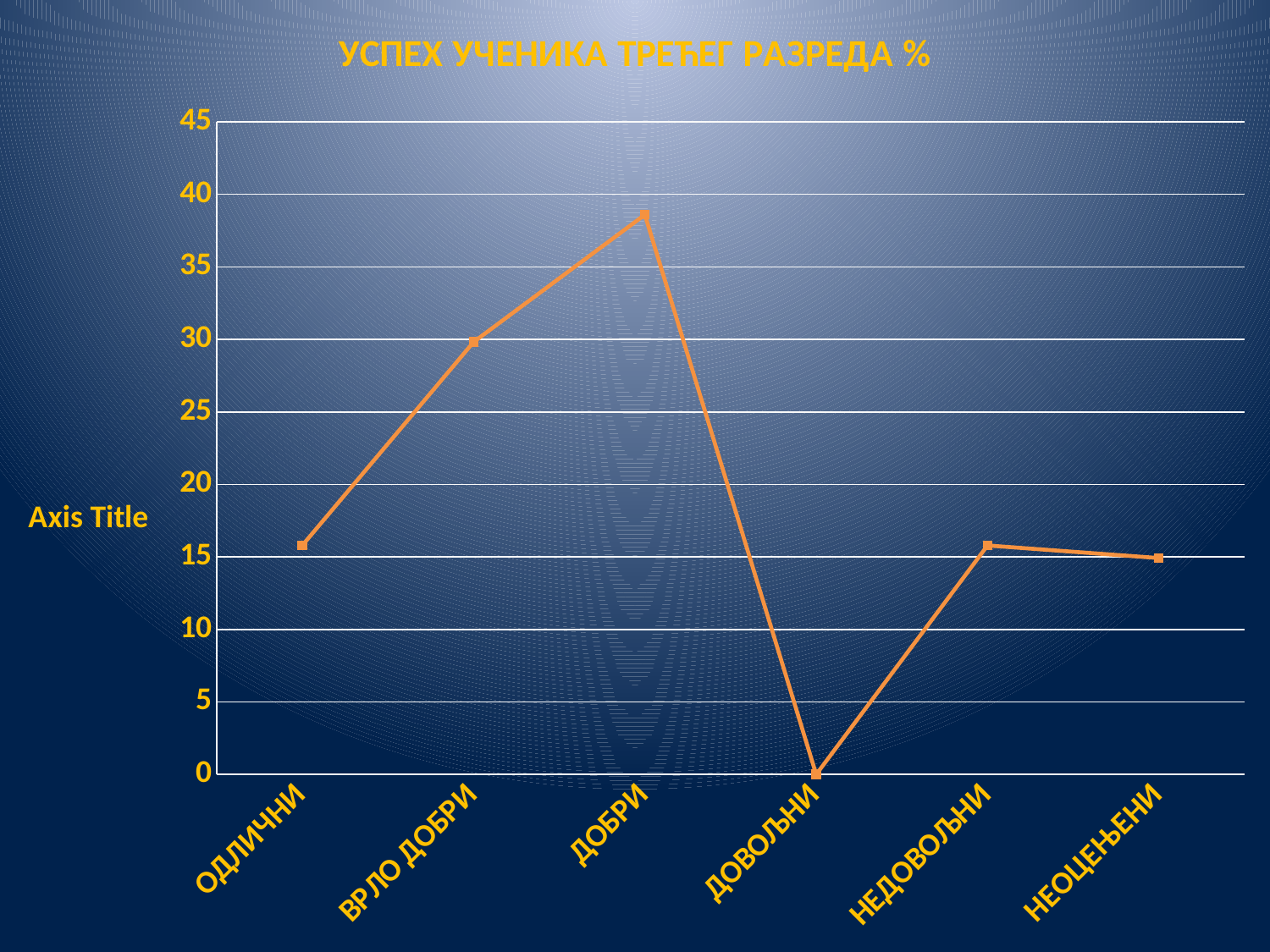
What is the value for ДОВОЉНИ? 0 What type of chart is shown on the slide? line chart What is the title of the chart? УСПЕХ УЧЕНИКА ТРЕЋЕГ РАЗРЕДА % Do the values rise or fall from ОДЛИЧНИ to ДОБРИ? rise Is the value for ВРЛО ДОБРИ greater or less than 25? greater Is the value for ОДЛИЧНИ greater or less than 20? less Which is larger, the value for ВРЛО ДОБРИ or the value for ОДЛИЧНИ? ВРЛО ДОБРИ How many categories are plotted along the x axis? 6 Which category has the lowest value? ДОВОЉНИ Is the value for ДОБРИ greater or less than 35? greater Which category has the highest value? ДОБРИ